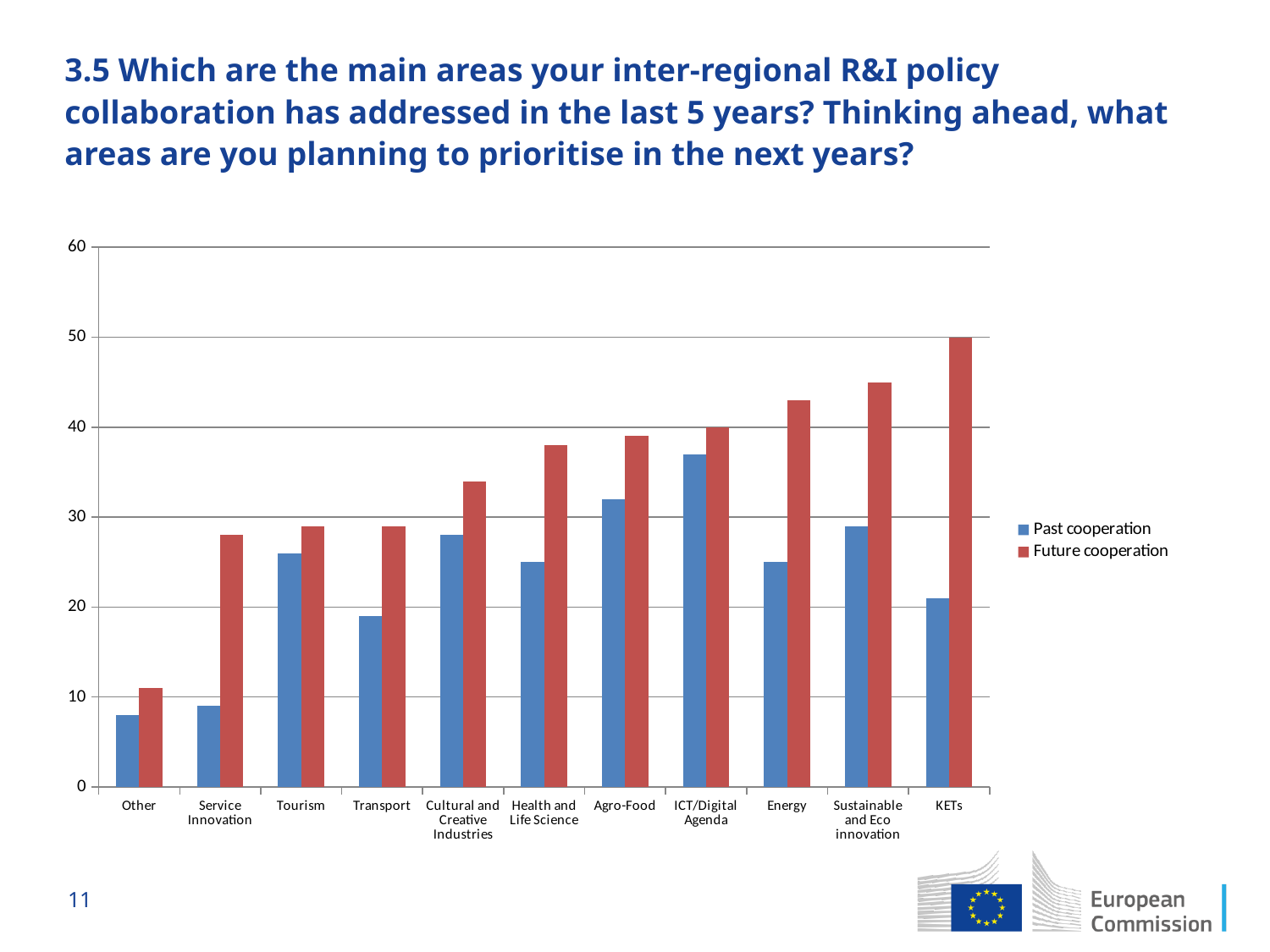
Which category has the highest Future cooperation value? KETs Is the Future cooperation value for Energy greater or less than 40? greater What is the Future cooperation value for KETs? 50 Which is larger for Service Innovation: Past cooperation or Future cooperation? Future cooperation What kind of chart is shown on the slide? bar chart Which category has the highest Past cooperation value? ICT/Digital Agenda How many categories are shown on the x axis? 11 Is the Past cooperation value for Transport greater or less than 20? less What colour are the Future cooperation bars? red How many series does the legend list? 2 Which category has the lowest Past cooperation value? Other What is the Future cooperation value for ICT/Digital Agenda? 40